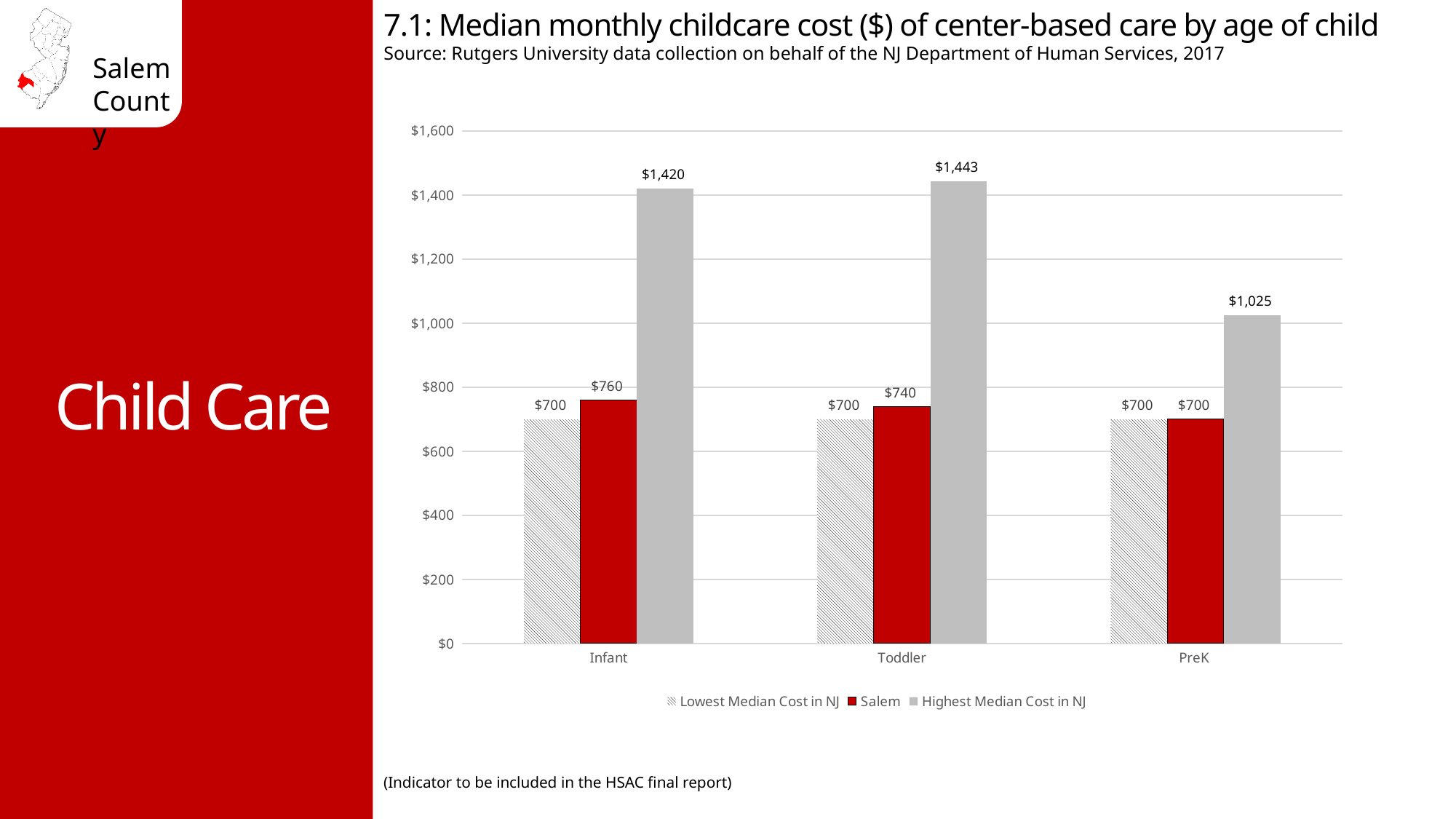
Which is larger, the Salem cost for Infant care or the Salem cost for PreK care? Infant How many series does the legend list? 3 Is the Highest Median Cost in NJ for PreK care greater or less than $1,200? less What is the difference between the Highest Median Cost in NJ and the Salem cost for Infant care? $660 What is the median monthly childcare cost for Salem for Infant care? $760 Which age group has the lowest value for the Highest Median Cost in NJ series? PreK What is the difference between the Salem cost for Infant care and the Salem cost for Toddler care? $20 Which age group has the highest value for the Highest Median Cost in NJ series? Toddler What kind of chart is shown on the slide? bar chart How many age groups are shown on the x axis? 3 What is the Lowest Median Cost in NJ for PreK care? $700 What is the Highest Median Cost in NJ for Toddler care? $1,443